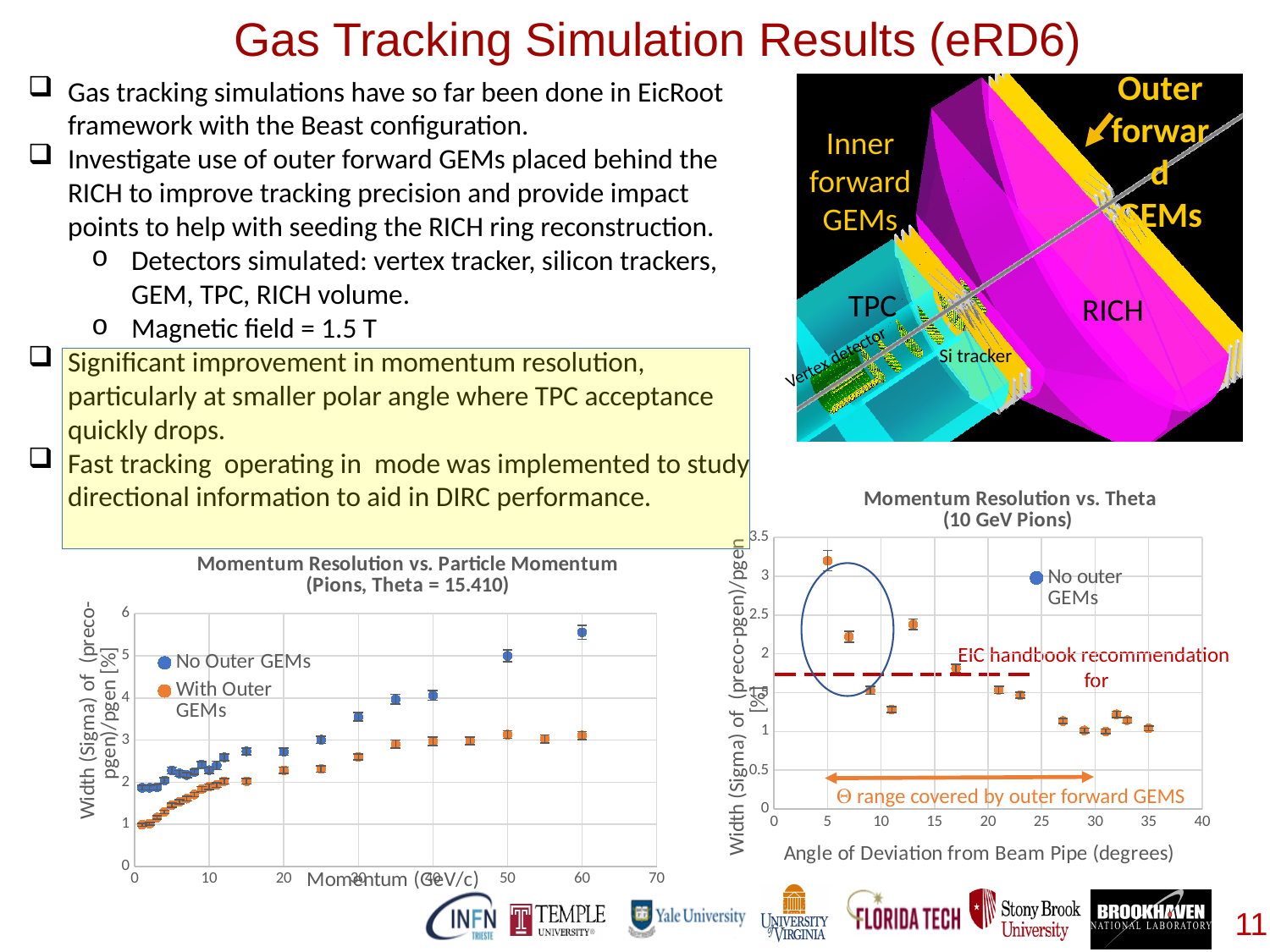
What is the x-axis title of the "Momentum Resolution vs. Particle Momentum" chart? Momentum (GeV/c) What type of chart is the "Momentum Resolution vs. Particle Momentum" chart on the left? scatter chart In the "Momentum Resolution vs. Particle Momentum" chart, which series has the higher values across the momentum range: No Outer GEMs or With Outer GEMs? No Outer GEMs In the "Momentum Resolution vs. Particle Momentum" chart, is the No Outer GEMs value at 60 GeV/c greater or less than 5? greater In the "Momentum Resolution vs. Particle Momentum" chart, is the With Outer GEMs value at 1 GeV/c greater or less than 2? less In the "Momentum Resolution vs. Particle Momentum" chart, do the No Outer GEMs values rise or fall as momentum increases? rise How many series does the legend of the "Momentum Resolution vs. Particle Momentum" chart list? 2 In the "Momentum Resolution vs. Theta (10 GeV Pions)" chart, do the values generally rise or fall as the angle increases from 5 to 35 degrees? fall In the "Momentum Resolution vs. Theta (10 GeV Pions)" chart, is the value at 35 degrees greater or less than 1.5? less